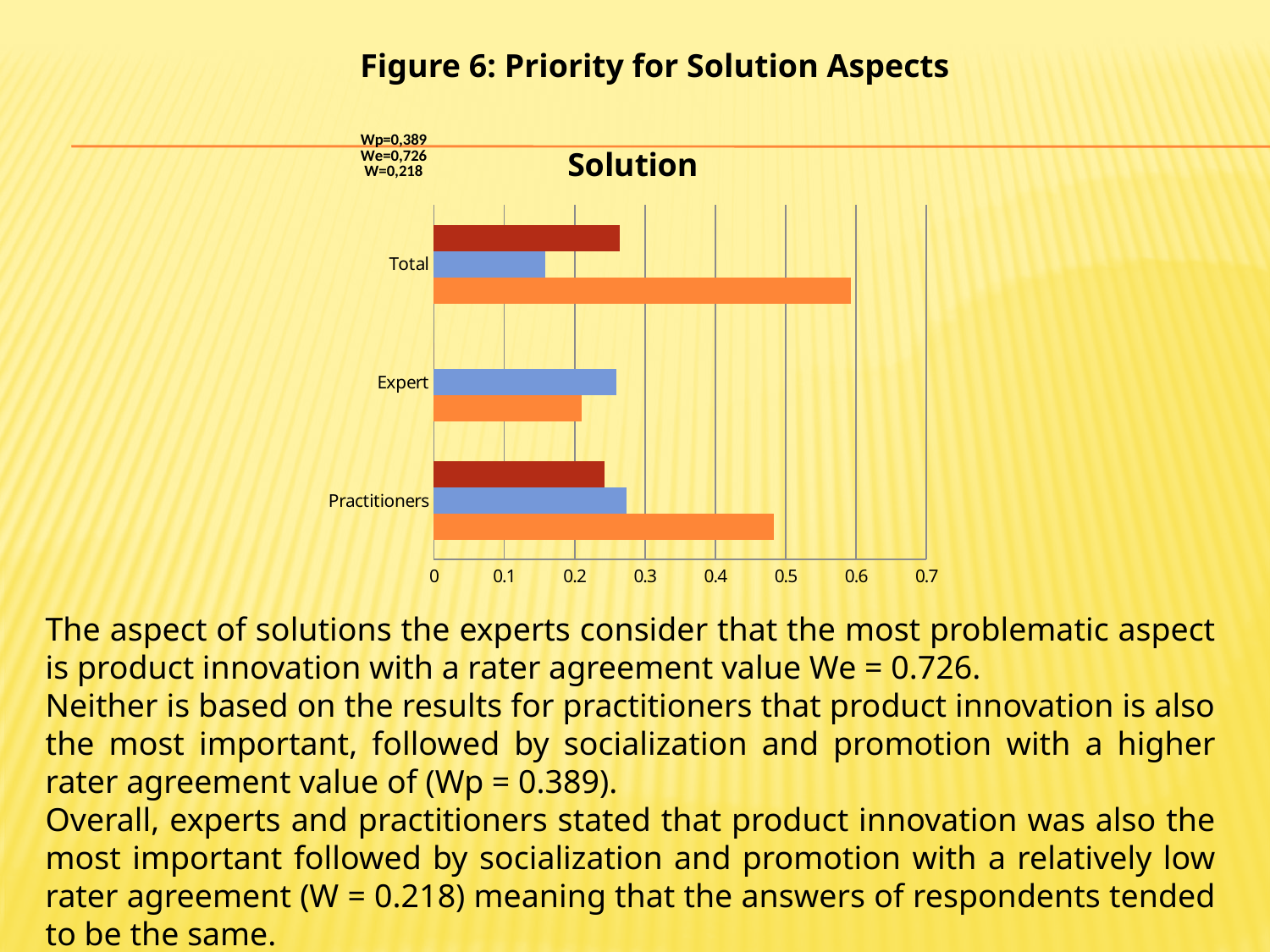
Is the value of the dark red bar for Total greater or less than 0.2? greater What is the title printed above the chart? Solution What is the highest value shown on the horizontal axis of the chart? 0.7 Which category has the longest orange bar? Total Which is larger for Total, the dark red bar or the blue bar? the dark red bar Is the value of the blue bar for Total greater or less than 0.2? less Is the value of the orange bar for Total greater or less than 0.5? greater What kind of chart is shown on the slide? bar chart Which is larger, the orange bar for Total or the orange bar for Practitioners? Total How many categories are shown on the vertical axis of the chart? 3